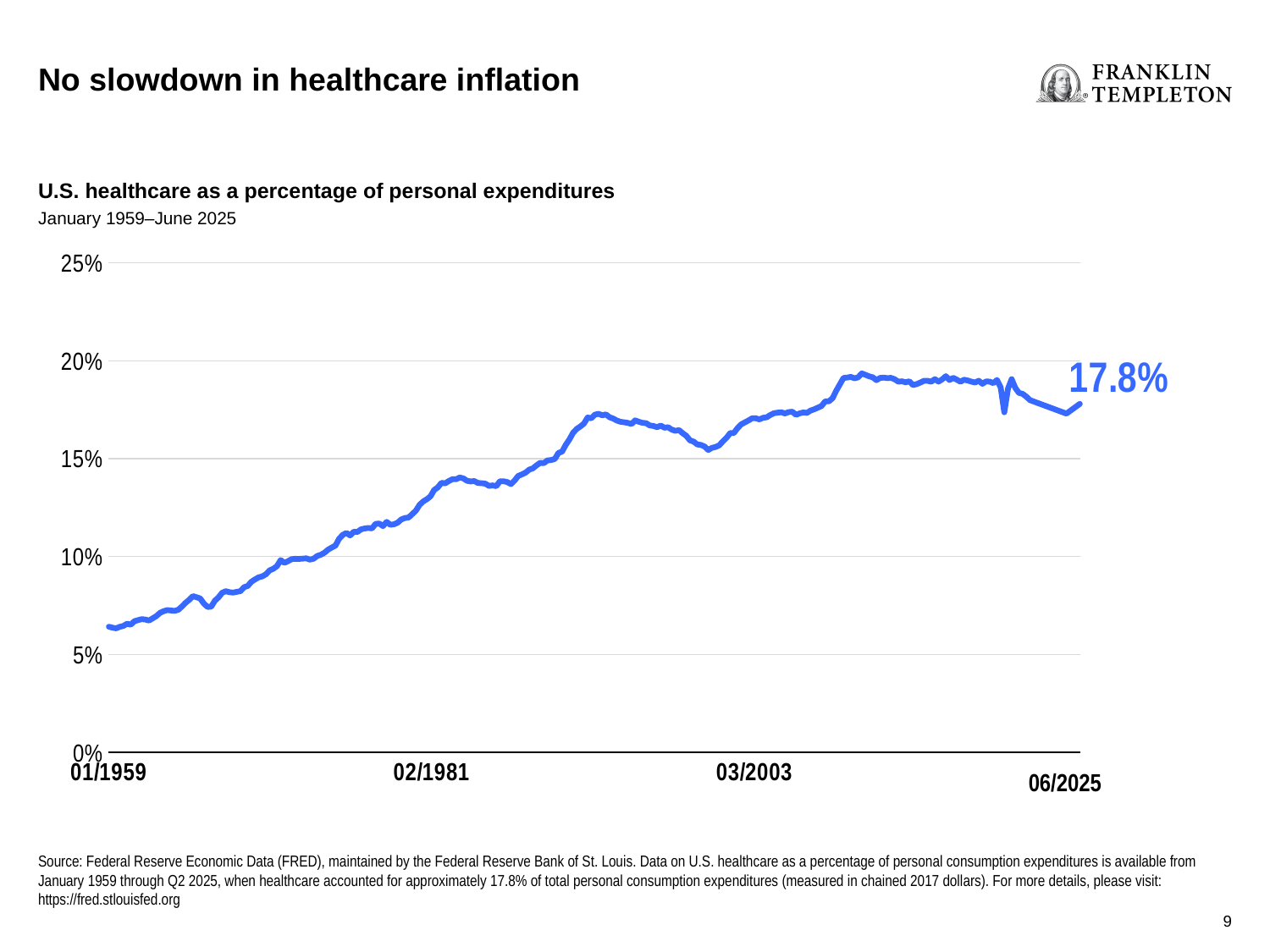
What is the title of the chart? U.S. healthcare as a percentage of personal expenditures Is the value at 03/2003 greater or less than 15%? greater What kind of chart is shown on the slide? line chart What is the highest value labelled on the y axis? 25% Do the values generally rise or fall from 01/1959 to 06/2025? rise Is the value at 02/1981 greater or less than 10%? greater Is the value at 01/1959 greater or less than 10%? less What date range does the chart subtitle give? January 1959–June 2025 Which is larger, the value at 01/1959 or the value at 06/2025? 06/2025 Which is larger, the value at 02/1981 or the value at 03/2003? 03/2003 What is the value shown for June 2025 on the chart? 17.8%